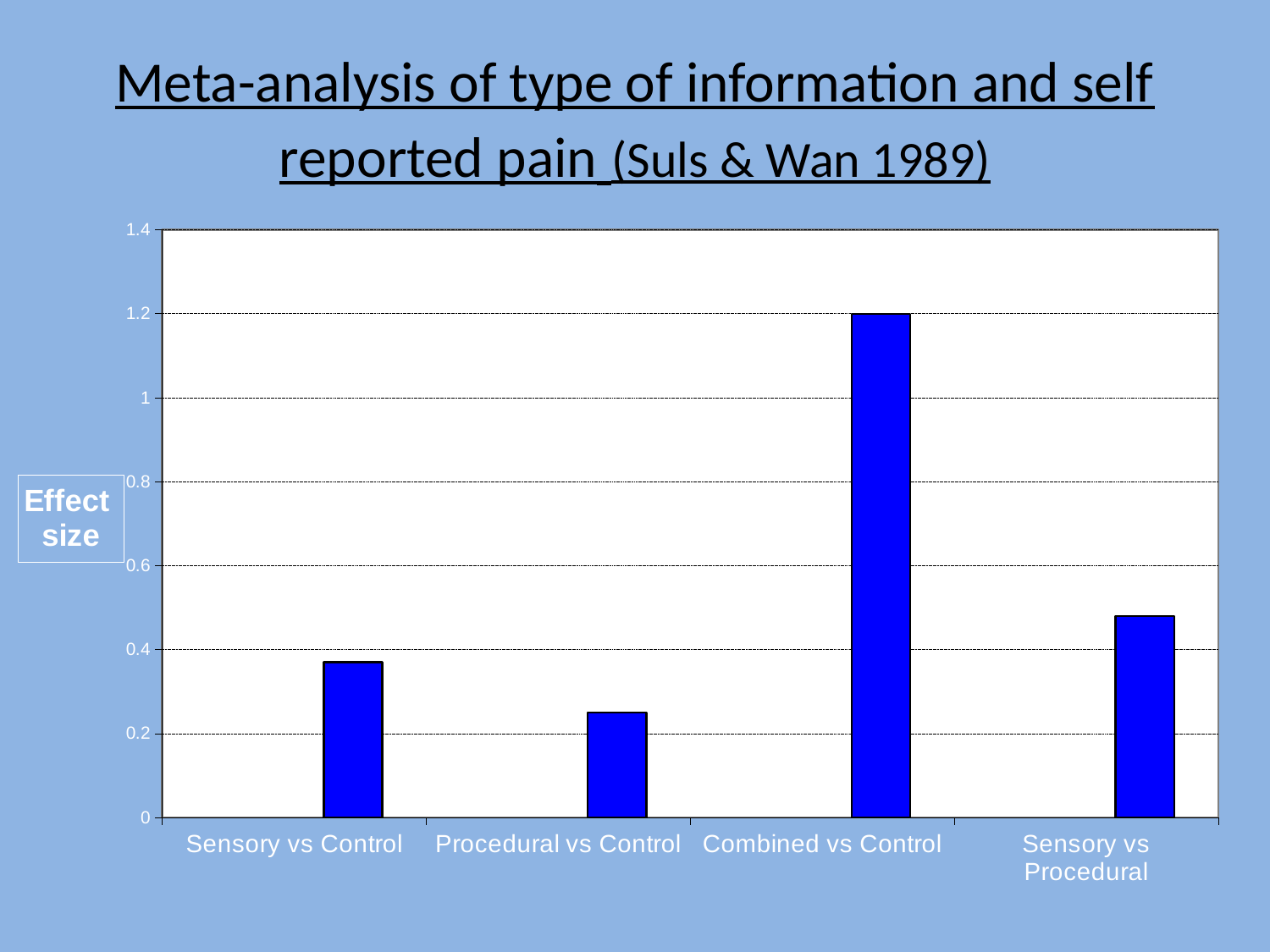
What kind of chart is shown on the slide? bar chart Which category has the lowest effect size? Procedural vs Control How many categories are plotted on the x axis? 4 Is the value for Procedural vs Control greater or less than 0.4? less Which is larger, the effect size for Sensory vs Procedural or for Sensory vs Control? Sensory vs Procedural What is the effect size for Combined vs Control? 1.2 Which study is cited in the slide title? Suls & Wan 1989 What label is given to the vertical axis of the chart? Effect size Which category has the highest effect size? Combined vs Control Is the value for Sensory vs Control greater or less than 0.2? greater Is the value for Sensory vs Procedural greater or less than 0.6? less